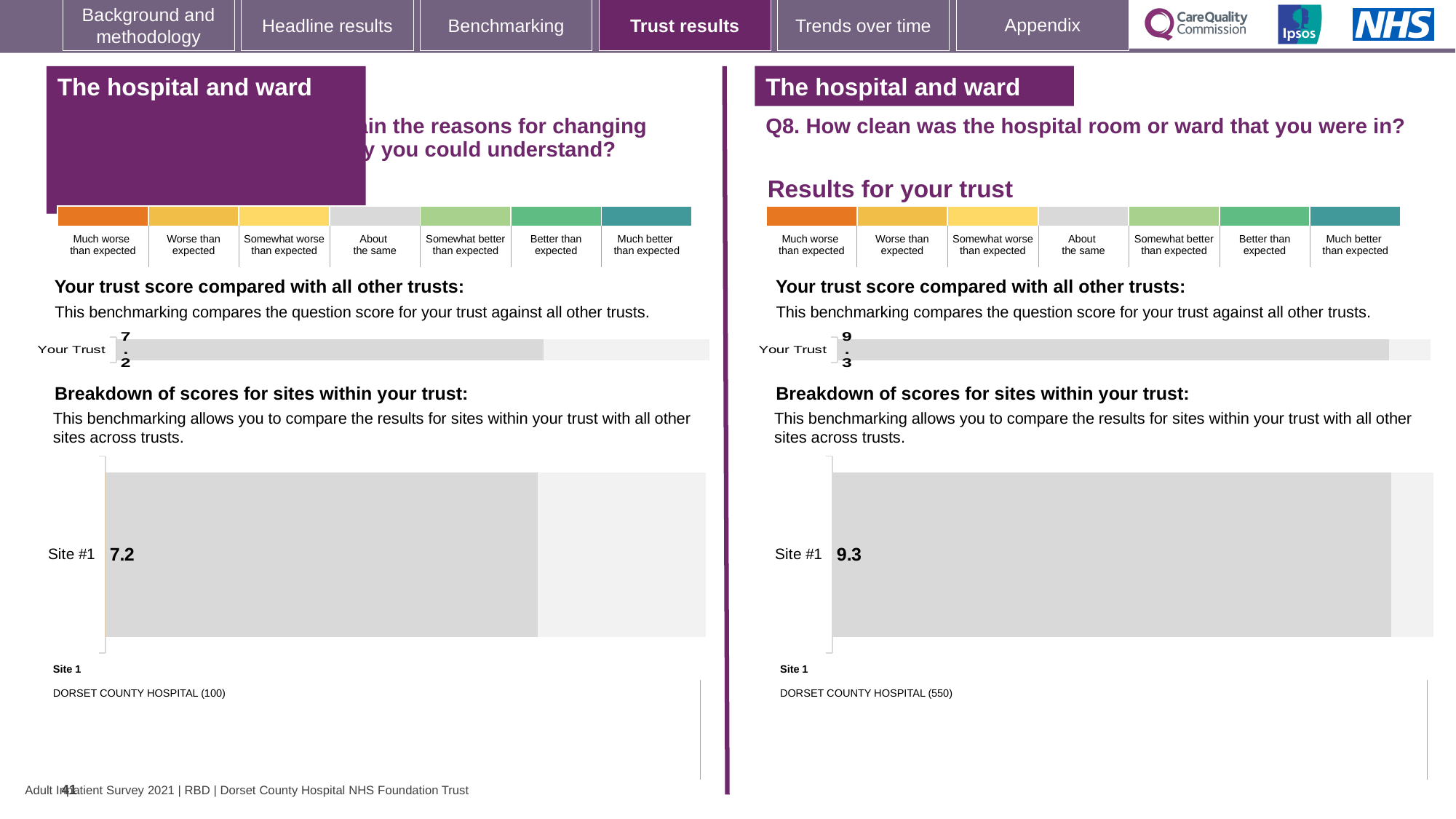
How many sites are shown in the left-hand breakdown of scores for sites within your trust? 1 How many sites are shown in the right-hand Q8 breakdown of scores for sites within your trust? 1 What is the difference between the Site #1 score on the right-hand Q8 chart and the Site #1 score on the left-hand chart? 2.1 On the left-hand chart, which site is listed as Site 1? DORSET COUNTY HOSPITAL (100) On the left-hand chart, what is the score shown for Your Trust? 7.2 On the right-hand Q8 breakdown of scores for sites within your trust, what is the score for Site #1? 9.3 What kind of chart is used to show the Site #1 score on the right-hand Q8 breakdown? Bar chart On the right-hand chart for Q8 (How clean was the hospital room or ward), what is the score shown for Your Trust? 9.3 Which is larger: the Your Trust score on the left-hand chart or the Your Trust score on the right-hand Q8 chart? Right-hand Q8 chart Is the Your Trust score on the left-hand chart greater or less than the Site #1 score on the right-hand Q8 chart? less On the right-hand Q8 chart, which site is listed as Site 1? DORSET COUNTY HOSPITAL (550) On the left-hand breakdown of scores for sites within your trust, what is the score for Site #1? 7.2